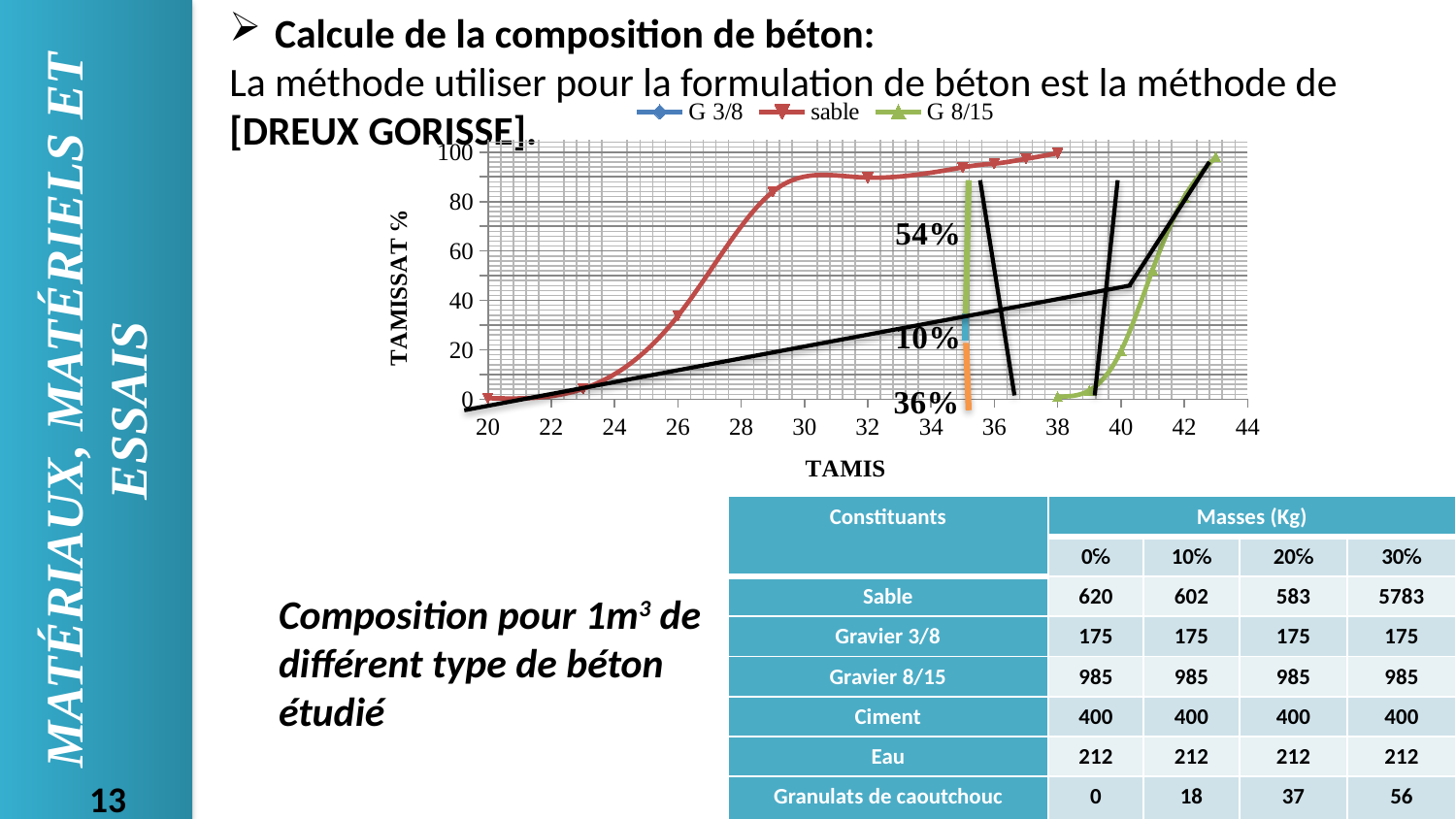
What kind of chart is shown on the slide? line chart What are the three series named in the chart legend? G 3/8, sable, G 8/15 Is the value of the sable curve at TAMIS 38 greater or less than 80? greater What percentage is written at the top of the vertical dashed line in the chart? 54% What is the highest value shown on the vertical axis of the chart? 100 Does the sable curve rise or fall as the TAMIS value increases along the x axis? rise At TAMIS 38, which series has the larger value, sable or G 8/15? sable Is the value of the G 8/15 curve at TAMIS 38 greater or less than 20? less Is the value of the sable curve at TAMIS 26 greater or less than 40? less What is the title of the vertical axis of the chart? TAMISSAT % How many series does the chart legend list? 3